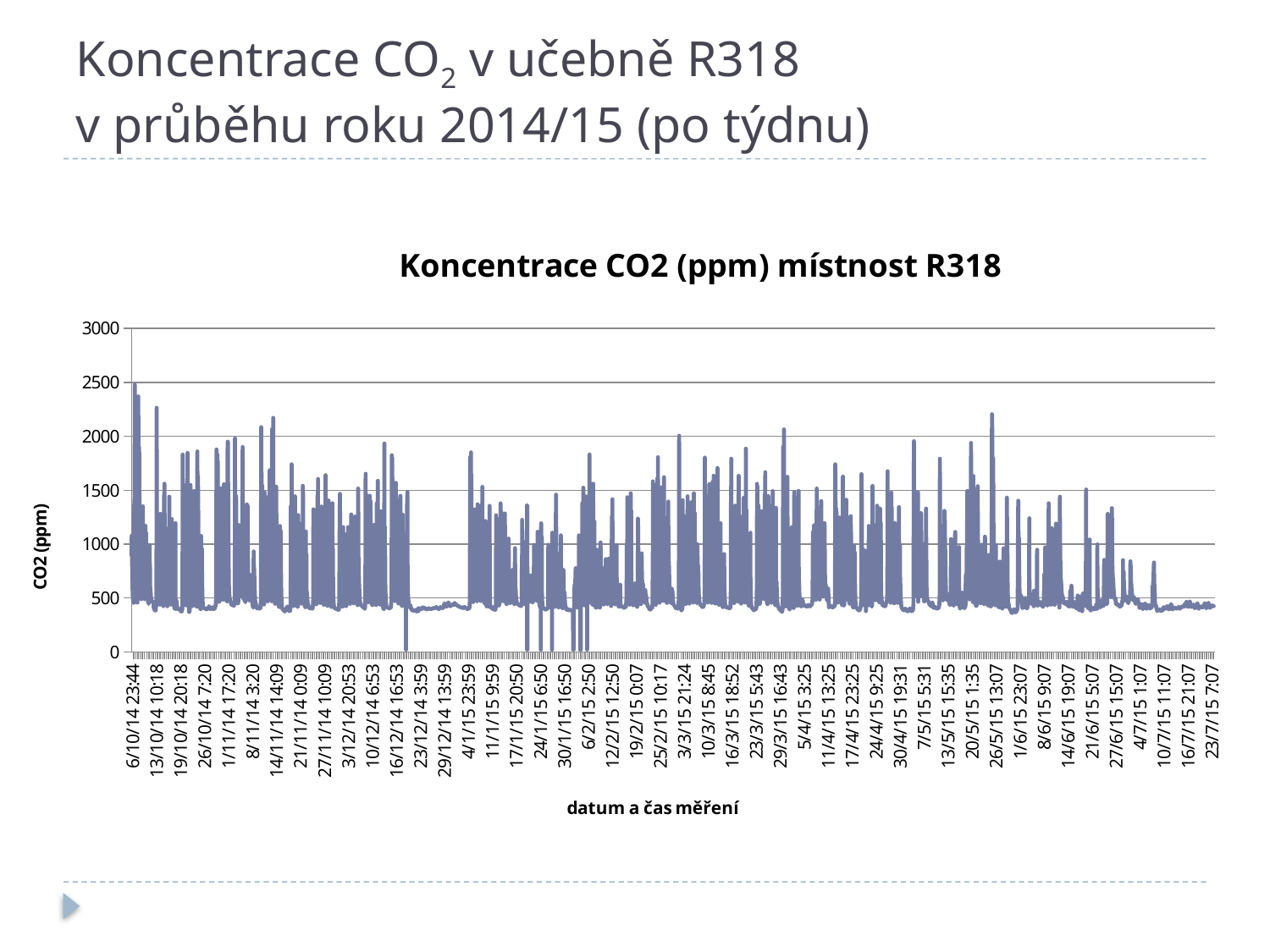
Is the baseline level between the peaks greater or less than 500? less Is the highest peak on the chart (near 6/10/14) greater or less than 2000? greater Is the value around 23/12/14 3:59 greater or less than 1000? less What is the title of the chart? Koncentrace CO2 (ppm) místnost R318 What is the first date-time label on the horizontal axis? 6/10/14 23:44 What is the highest tick value shown on the vertical axis? 3000 What kind of chart is shown on the slide? line chart What is the last date-time label on the horizontal axis? 23/7/15 7:07 What is the label of the vertical axis of the chart? CO2 (ppm) How many data series are plotted on the chart? 1